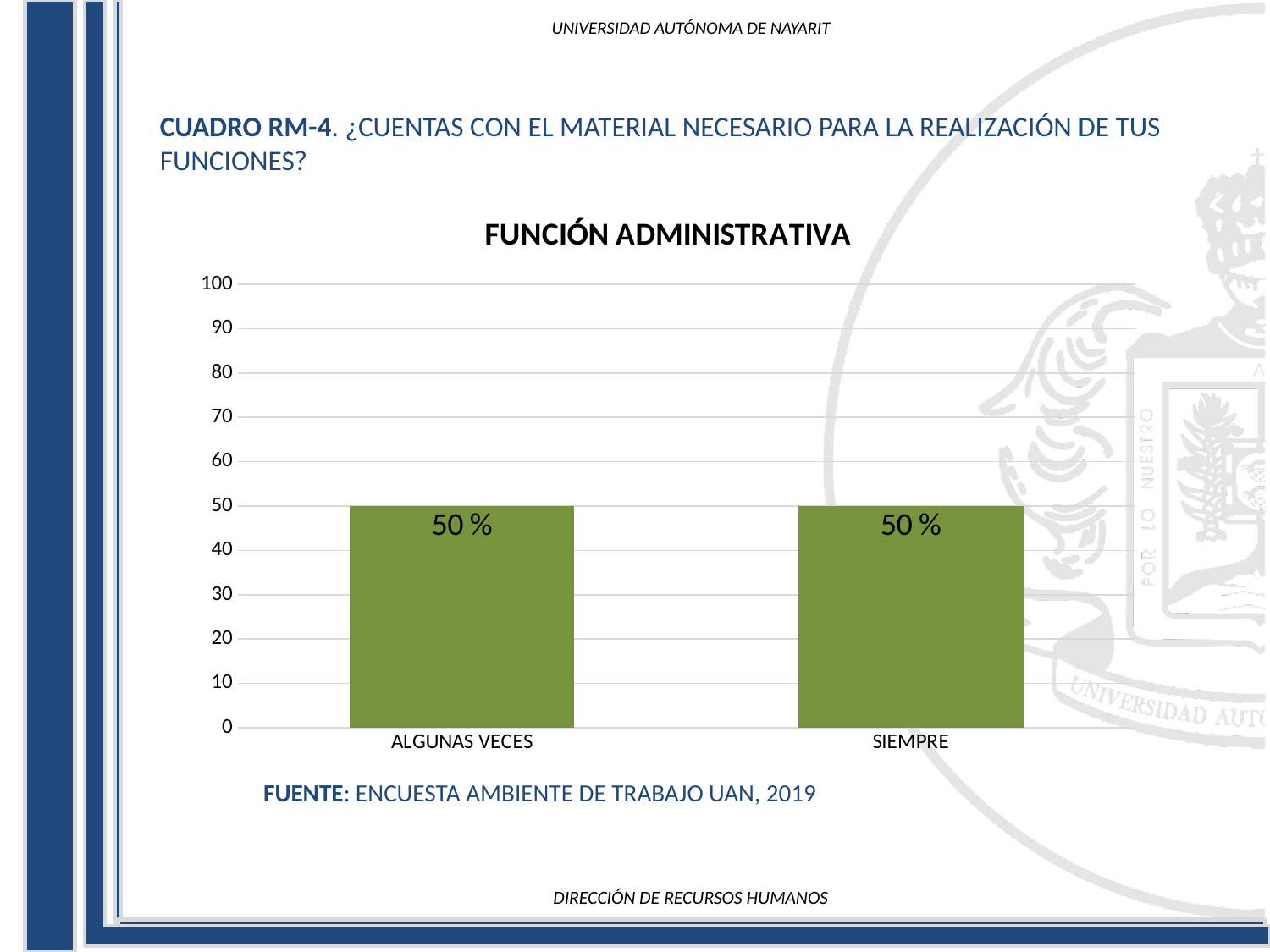
What is the value for ALGUNAS VECES? 50 % What is the total of the values for ALGUNAS VECES and SIEMPRE? 100 % How many categories are shown on the x axis? 2 What is the value for SIEMPRE? 50 % Is the value for ALGUNAS VECES greater or less than 40? greater What is the title of the chart? FUNCIÓN ADMINISTRATIVA Is the value for SIEMPRE greater or less than 60? less What kind of chart is shown on the slide? bar chart What is the maximum value shown on the y axis? 100 What is the difference between the values for ALGUNAS VECES and SIEMPRE? 0